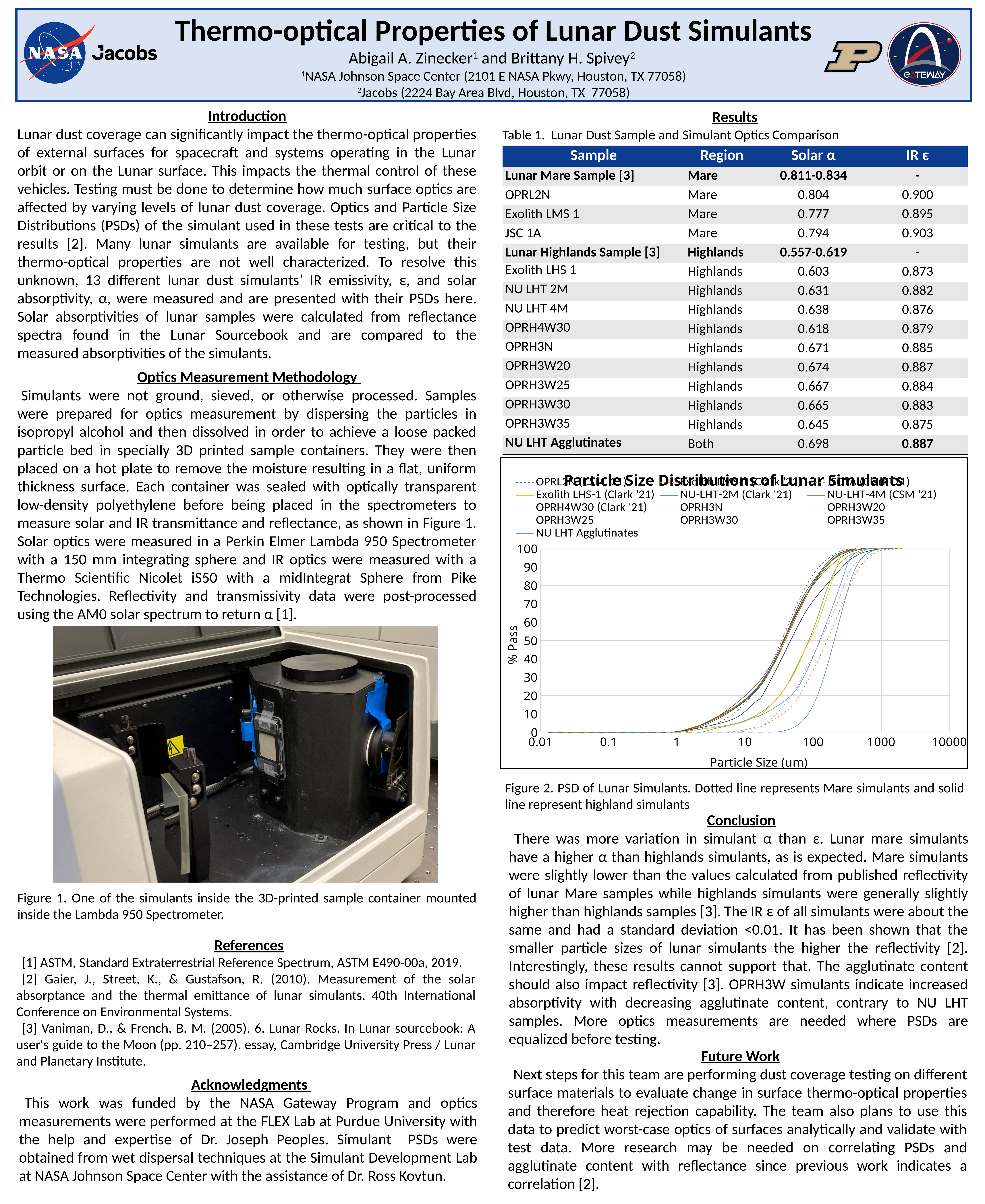
What kind of chart is the "Particle Size Distributions of Lunar Simulants" chart? line chart What is the title of the chart on the slide? Particle Size Distributions of Lunar Simulants What is the x-axis label of the "Particle Size Distributions of Lunar Simulants" chart? Particle Size (um) In the "Particle Size Distributions of Lunar Simulants" chart, at a particle size of 1000 um, are the % Pass values for the simulants greater or less than 90? greater In the "Particle Size Distributions of Lunar Simulants" chart, at a particle size of 1 um, are the % Pass values for the simulants greater or less than 10? less In the "Particle Size Distributions of Lunar Simulants" chart, do the % Pass values rise or fall as particle size increases? rise